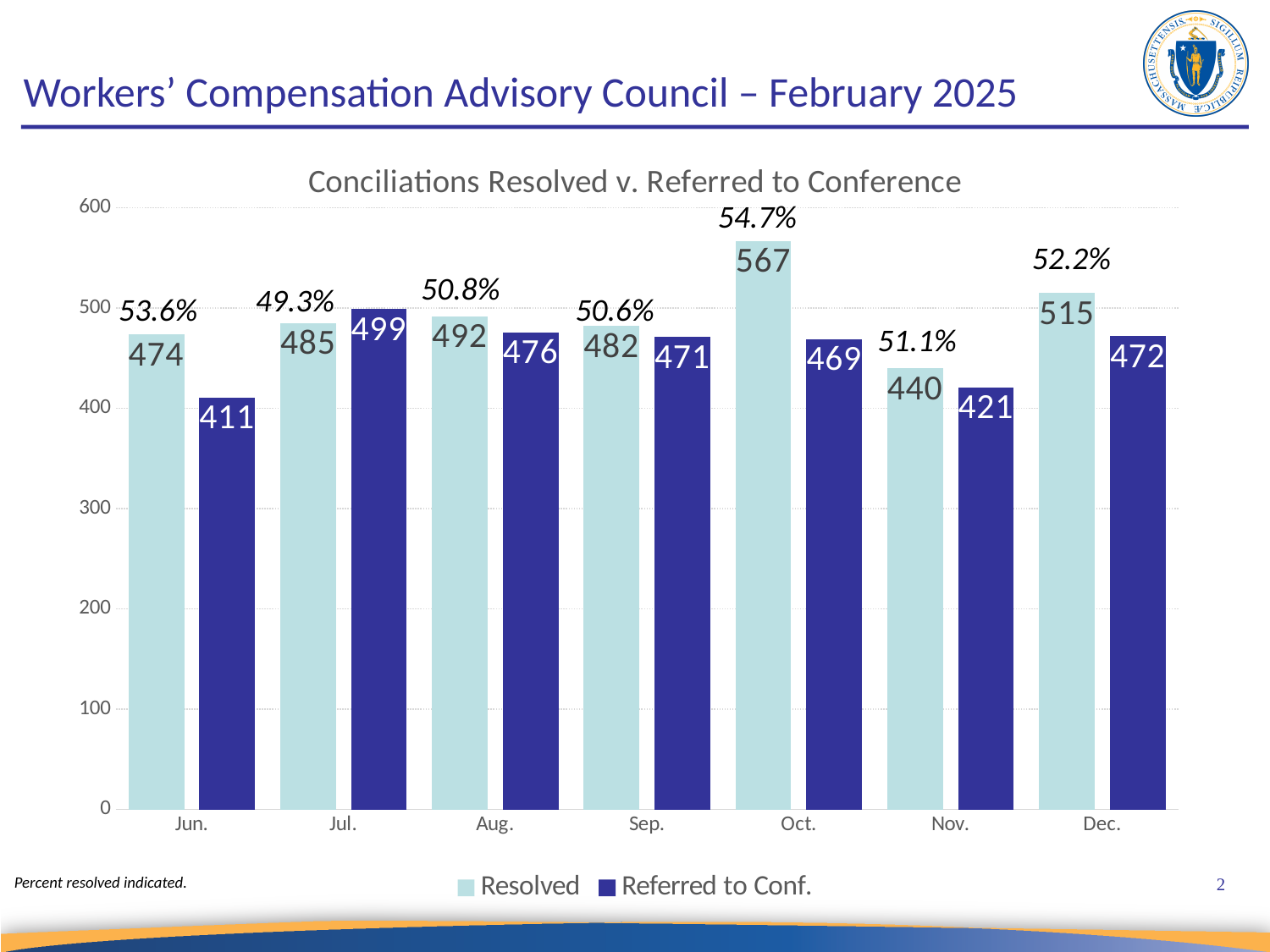
What is the Resolved value for Oct.? 567 Is the Resolved value for Nov. greater or less than 500? less What kind of chart is shown? bar chart Which month has the lowest Referred to Conf. value? Jun. How many months are shown on the x axis? 7 How many series does the legend list? 2 Which is larger in Jul., Resolved or Referred to Conf.? Referred to Conf. Which month has the highest Resolved value? Oct. What is the difference between Resolved and Referred to Conf. in Oct.? 98 What is the Referred to Conf. value for Jun.? 411 What percent resolved is indicated for Dec.? 52.2% What is the title of the chart? Conciliations Resolved v. Referred to Conference